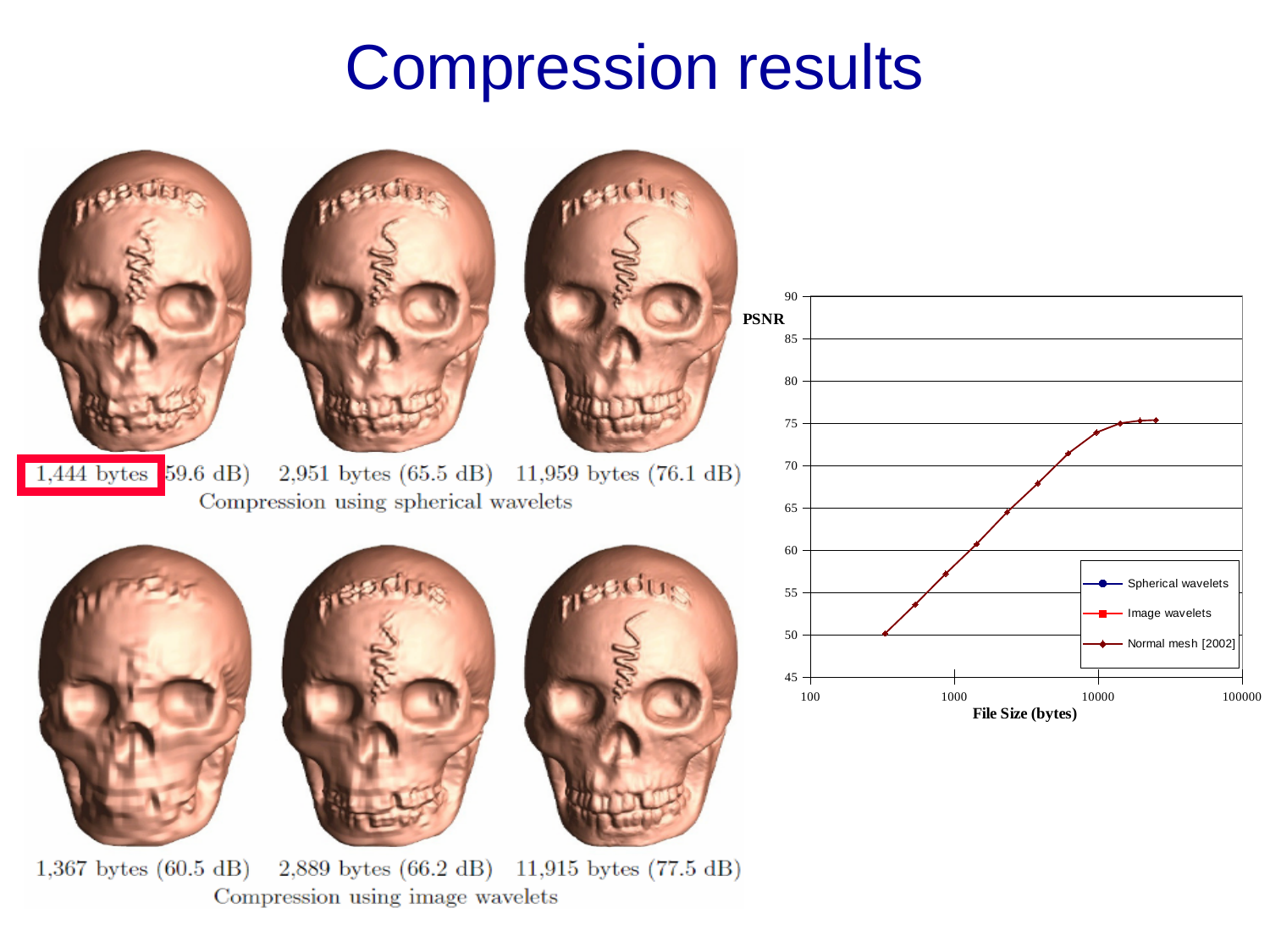
Is the PSNR value at a file size of 1000 bytes greater or less than 65? less How many series does the legend of the chart list? 3 Is the lowest PSNR value plotted on the chart greater or less than 45? greater Is the PSNR value at a file size of 10000 bytes greater or less than 80? less Does the PSNR value rise or fall as file size increases along the x axis? rise What kind of chart is shown on the right of the slide? line chart What is the label of the x axis of the chart? File Size (bytes) What is the label of the y axis of the chart? PSNR